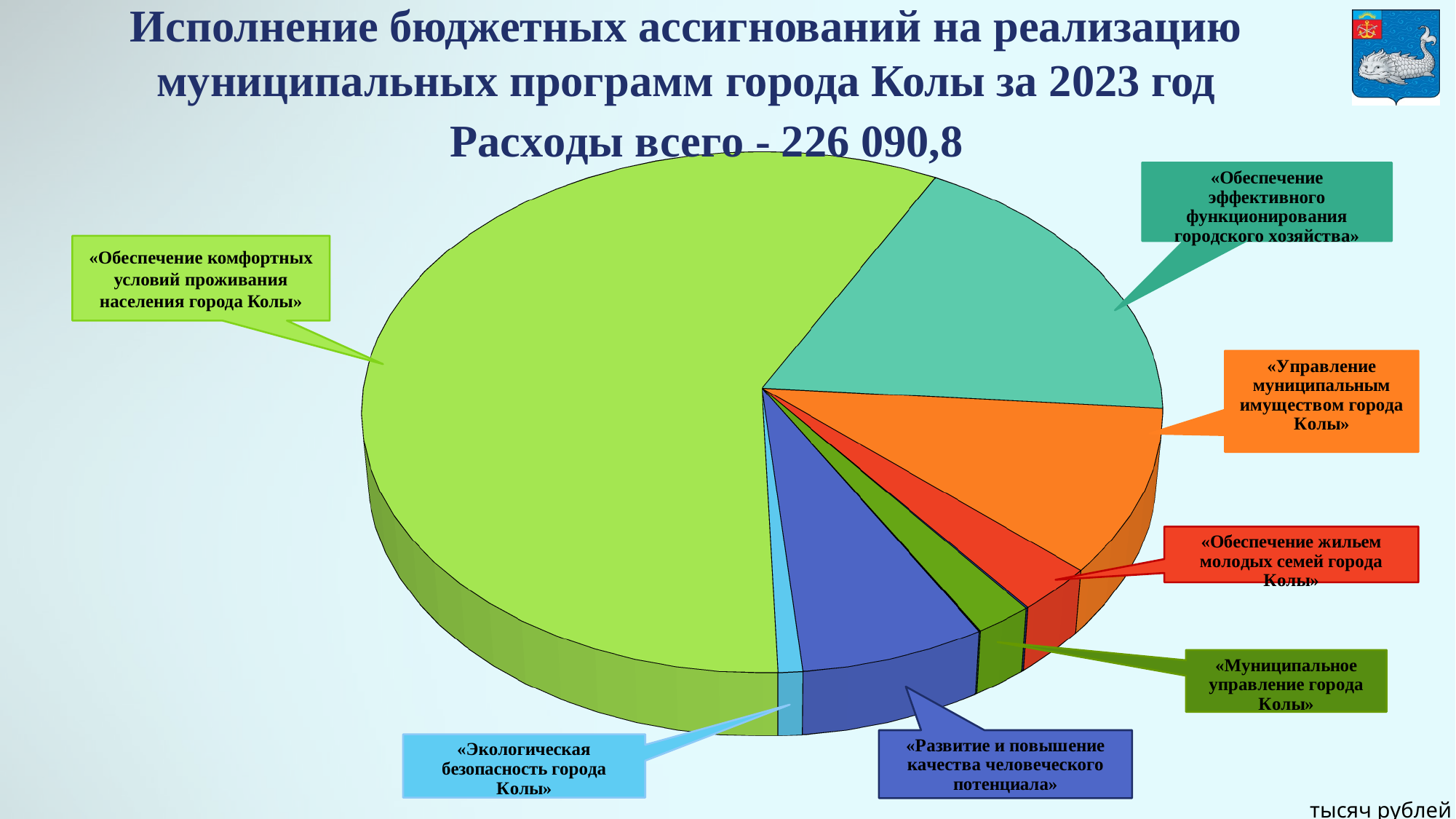
In what units are the values on the slide expressed? тысяч рублей Which municipal programme has the smallest slice of the pie chart? «Экологическая безопасность города Колы» What kind of chart is shown on the slide? Pie chart Which slice is larger: «Обеспечение комфортных условий проживания населения города Колы» or «Обеспечение эффективного функционирования городского хозяйства»? «Обеспечение комфортных условий проживания населения города Колы» How many slices (municipal programmes) does the pie chart have? 7 Which colour is the slice for «Управление муниципальным имуществом города Колы»? Orange Which slice is larger: «Обеспечение эффективного функционирования городского хозяйства» or «Развитие и повышение качества человеческого потенциала»? «Обеспечение эффективного функционирования городского хозяйства» What total expenditure (Расходы всего) is stated on the slide? 226 090,8 Which slice is larger: «Развитие и повышение качества человеческого потенциала» or «Обеспечение жильем молодых семей города Колы»? «Развитие и повышение качества человеческого потенциала» Which municipal programme has the largest slice of the pie chart? «Обеспечение комфортных условий проживания населения города Колы»